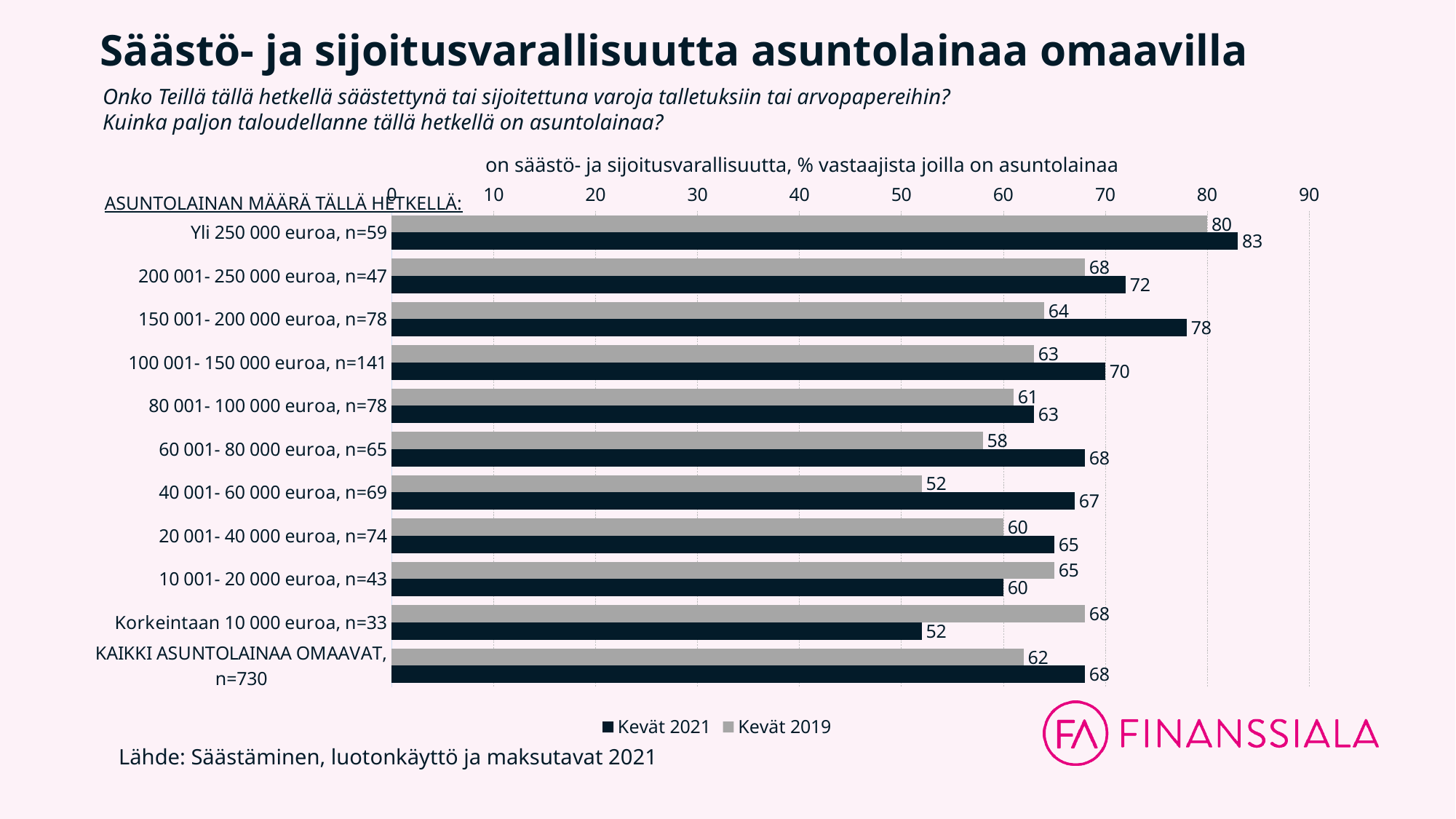
Which category has the highest Kevät 2021 value? Yli 250 000 euroa, n=59 For "10 001- 20 000 euroa, n=43", which is larger: the Kevät 2021 value or the Kevät 2019 value? Kevät 2019 What is the Kevät 2019 value for "Korkeintaan 10 000 euroa, n=33"? 68 Which category has the lowest Kevät 2021 value? Korkeintaan 10 000 euroa, n=33 What is the Kevät 2021 value for "Yli 250 000 euroa, n=59"? 83 What kind of chart is shown on the slide? Bar chart Which category has the lowest Kevät 2019 value? 40 001- 60 000 euroa, n=69 How many series does the legend list? 2 What are the two series listed in the legend? Kevät 2021 and Kevät 2019 What is the difference between the Kevät 2021 and Kevät 2019 values for "150 001- 200 000 euroa, n=78"? 14 What is the Kevät 2021 value for "KAIKKI ASUNTOLAINAA OMAAVAT, n=730"? 68 How many categories are shown on the chart? 11